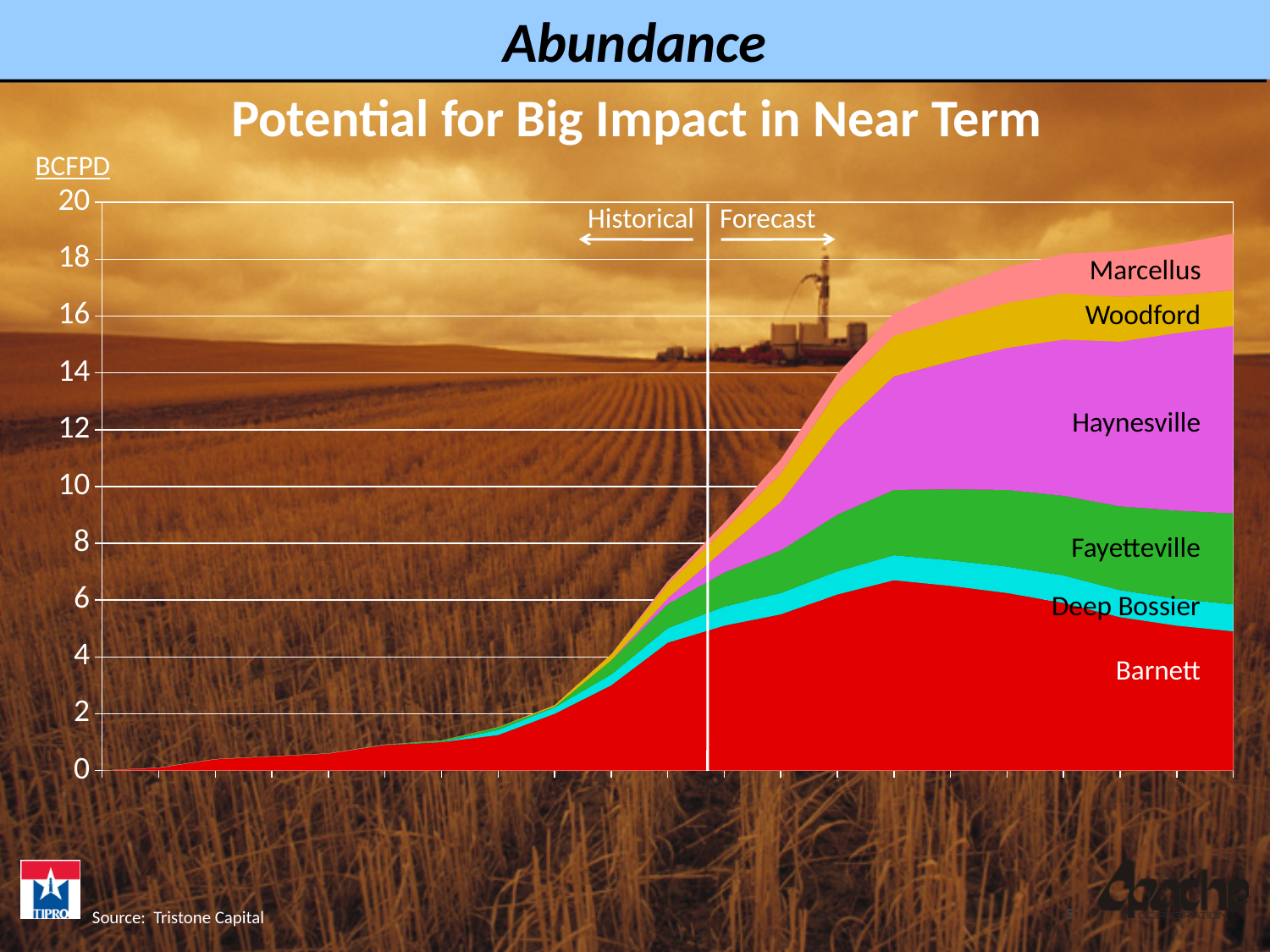
What is the interval between consecutive y-axis tick labels? 2 Which series forms the top layer of the stacked area chart? Marcellus What is the highest value labelled on the y axis? 20 What kind of chart is shown on the slide? Stacked area chart At the right edge of the chart, which series is thicker: Haynesville or Fayetteville? Haynesville What two periods does the vertical white line separate on the chart? Historical and Forecast How many series (plays) are labelled on the chart? 6 At the right edge of the chart, is the Barnett value greater or less than 6? less What unit is shown on the y axis? BCFPD Does the total stacked value rise or fall moving from left to right along the x axis? Rise Which series forms the bottom layer of the stacked area chart? Barnett At the right edge of the chart, is the total stacked value greater or less than 18? greater